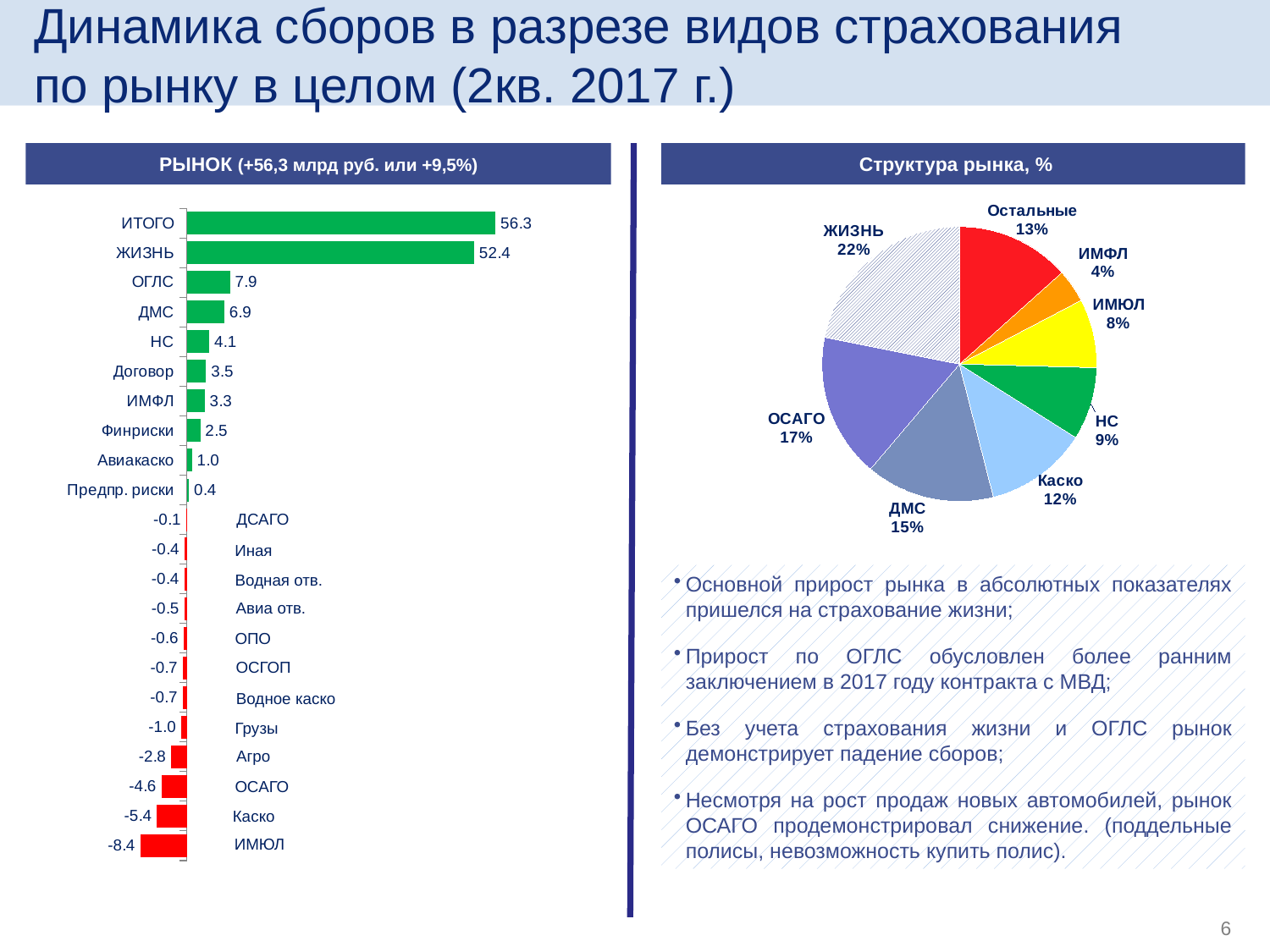
In the bar chart titled «РЫНОК», which is larger, the value for Каско or the value for Агро? Агро In the bar chart titled «РЫНОК», what is the difference between the values for ОГЛС and ДМС? 1.0 In the bar chart titled «РЫНОК», which category has the lowest value? ИМЮЛ What kind of chart is the chart titled «РЫНОК»? Bar chart In the bar chart titled «РЫНОК», what is the value for ОСАГО? -4.6 How many categories are shown in the bar chart titled «РЫНОК»? 22 In the bar chart titled «РЫНОК», what is the value for ИМЮЛ? -8.4 In the bar chart titled «РЫНОК», excluding ИТОГО, which category has the highest value? ЖИЗНЬ In the pie chart titled «Структура рынка, %», which slice is the largest? ЖИЗНЬ In the pie chart titled «Структура рынка, %», what share does ОСАГО have? 17% How many slices does the pie chart titled «Структура рынка, %» have? 8 In the bar chart titled «РЫНОК», what is the value for ЖИЗНЬ? 52.4